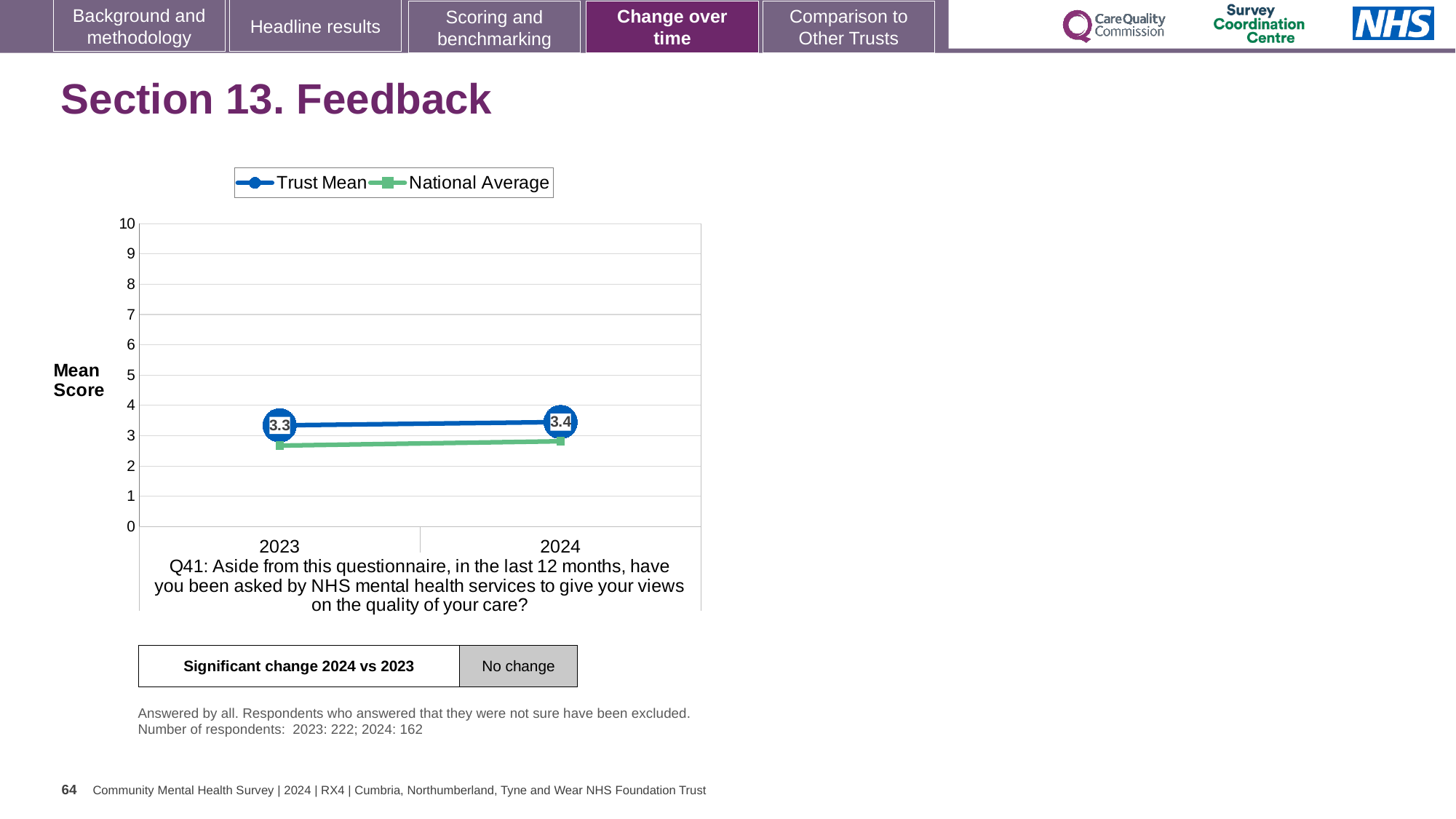
What is the Trust Mean value for 2023? 3.3 What is the difference between the Trust Mean in 2024 and in 2023? 0.1 What is the Trust Mean value for 2024? 3.4 In 2023, which series is higher, Trust Mean or National Average? Trust Mean What is the label on the y axis of the chart? Mean Score How many series does the legend list? 2 Is the National Average value for 2023 greater or less than 3? less Is the National Average value for 2024 greater or less than 4? less Which year has the higher Trust Mean, 2023 or 2024? 2024 How many years are plotted on the x axis? 2 What kind of chart is shown on the slide? line chart Does the Trust Mean rise or fall from 2023 to 2024? rise